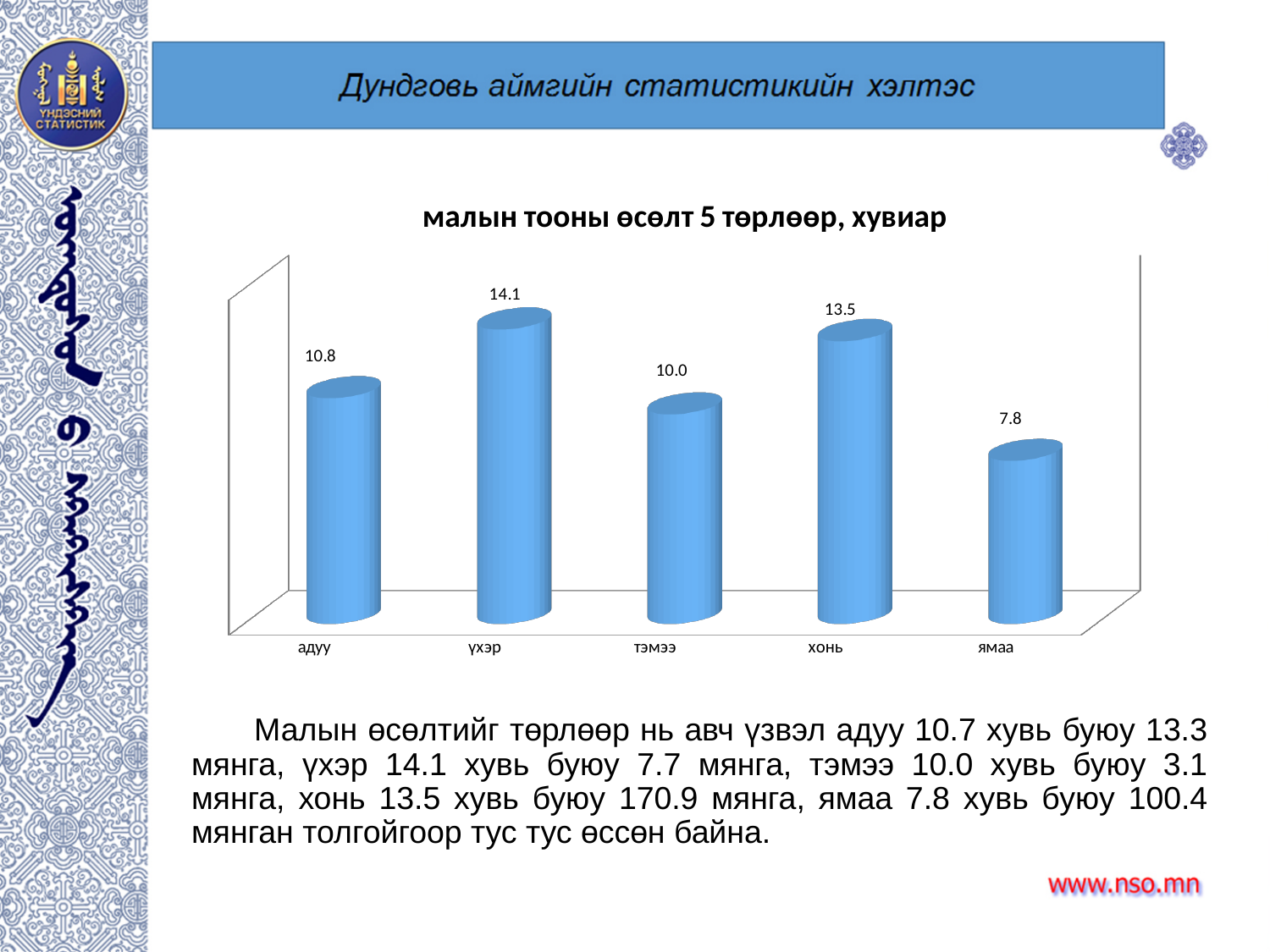
What is the title of the chart? малын тооны өсөлт 5 төрлөөр, хувиар What kind of chart is shown on the slide? bar chart What is the value for тэмээ? 10.0 Which is larger, the value for адуу or the value for тэмээ? адуу What is the value for хонь? 13.5 What is the difference between the values for үхэр and ямаа? 6.3 What is the value for үхэр? 14.1 What is the value for ямаа? 7.8 How many categories are shown in the chart? 5 What is the value for адуу? 10.8 Which category has the lowest value? ямаа Which category has the highest value? үхэр